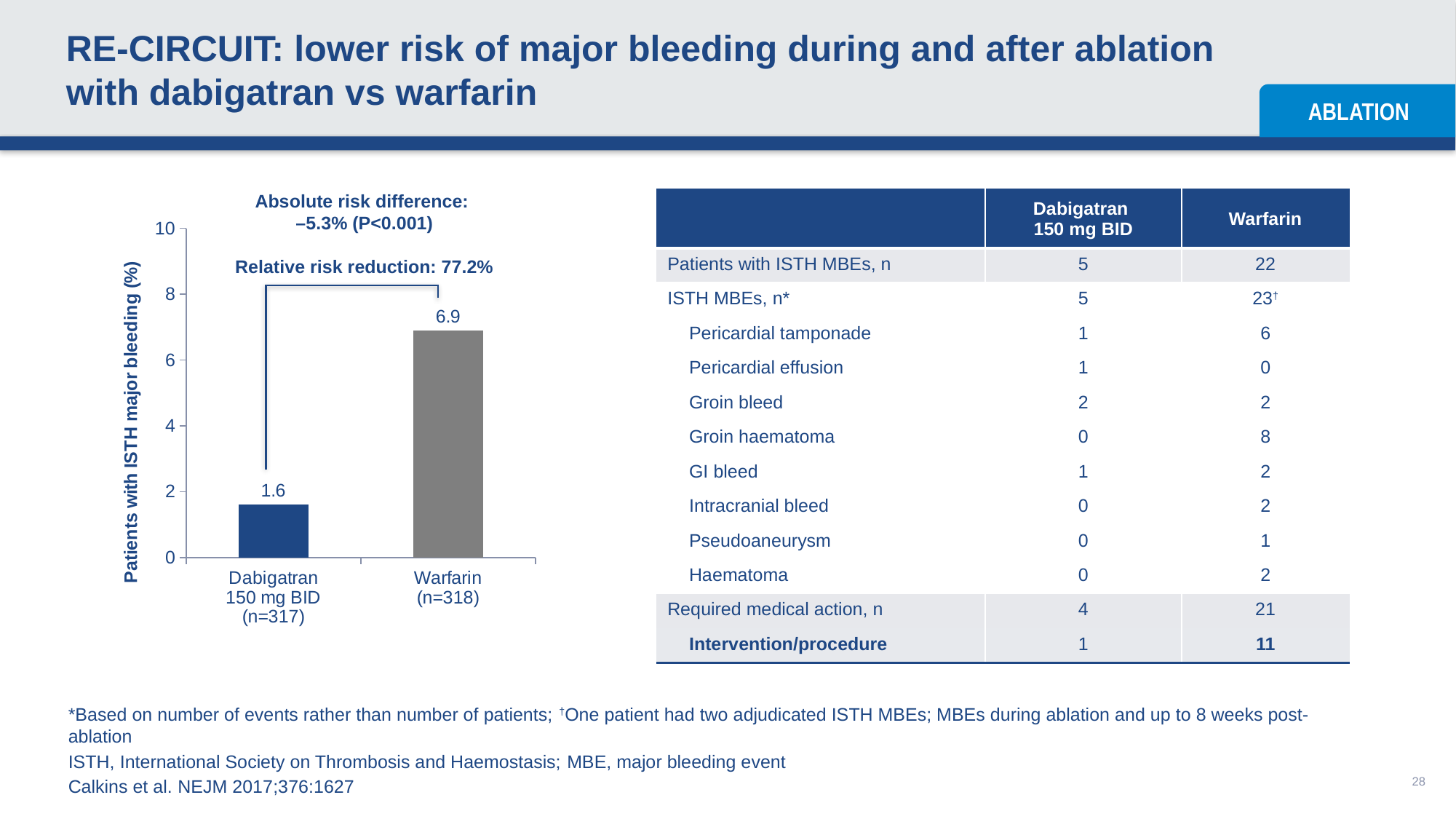
Which group has the lower percentage of patients with ISTH major bleeding in the bar chart? Dabigatran 150 mg BID What is the value for Warfarin in the bar chart? 6.9 What is the maximum value shown on the y-axis of the bar chart? 10 What is the difference between the Warfarin and Dabigatran 150 mg BID values in the bar chart? 5.3 What relative risk reduction is annotated on the bar chart? 77.2% What kind of chart is shown on the slide? Bar chart What is the value for Dabigatran 150 mg BID in the bar chart? 1.6 Which group has the higher percentage of patients with ISTH major bleeding in the bar chart? Warfarin What is the y-axis label of the bar chart? Patients with ISTH major bleeding (%) Is the value for Warfarin in the bar chart greater or less than 6? greater How many bars are shown in the bar chart? 2 Is the value for Dabigatran 150 mg BID in the bar chart greater or less than 2? less